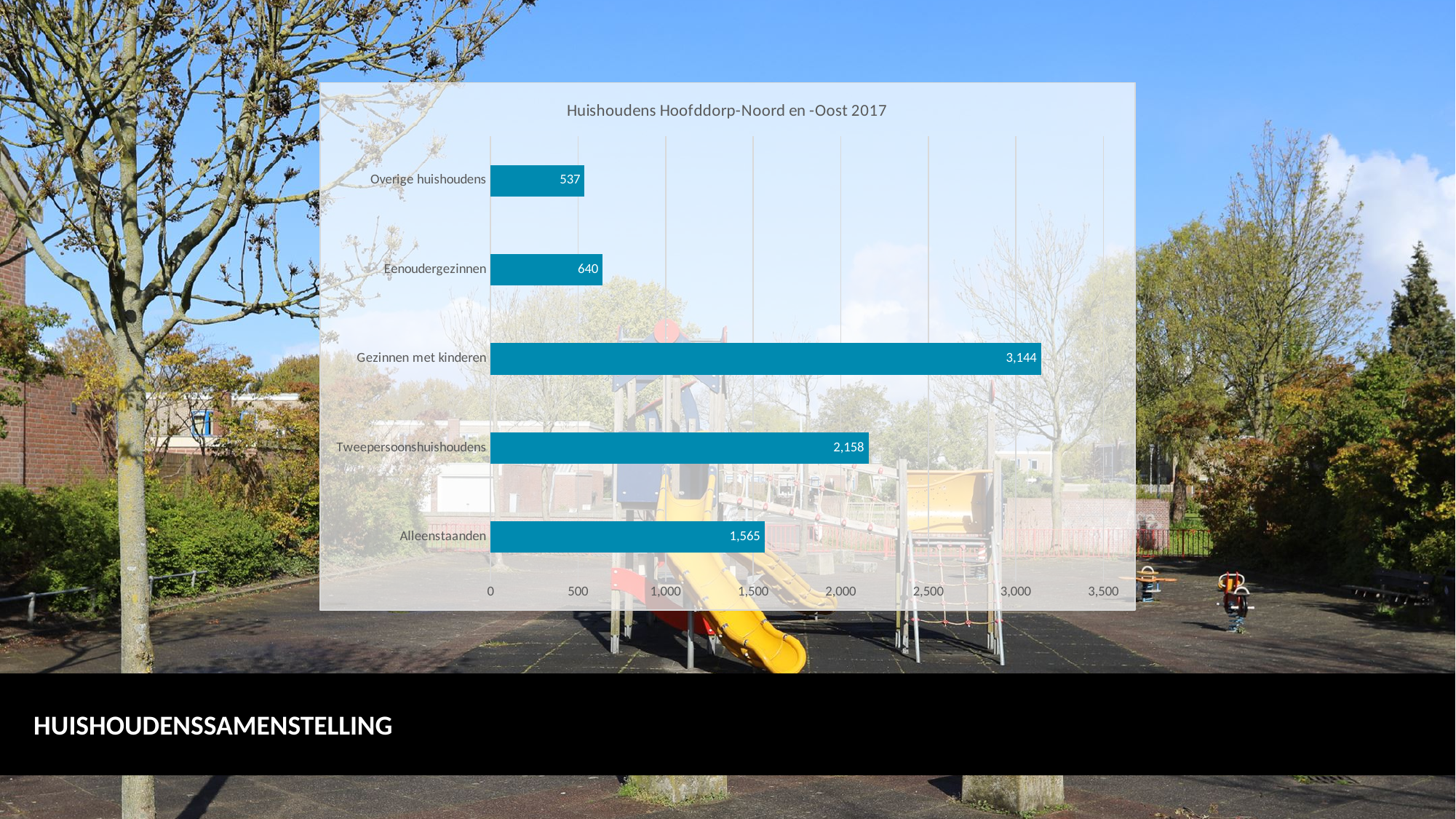
What kind of chart is shown on the slide? Bar chart Which category has the highest value? Gezinnen met kinderen What is the difference between Gezinnen met kinderen and Tweepersoonshuishoudens? 986 What is the value for Alleenstaanden? 1,565 What is the value for Overige huishoudens? 537 Which category has the lowest value? Overige huishoudens How many categories are shown in the chart? 5 Which is larger, Tweepersoonshuishoudens or Alleenstaanden? Tweepersoonshuishoudens What is the title of the chart? Huishoudens Hoofddorp-Noord en -Oost 2017 What is the value for Eenoudergezinnen? 640 What is the value for Gezinnen met kinderen? 3,144 Is the value for Tweepersoonshuishoudens greater or less than 2,000? greater